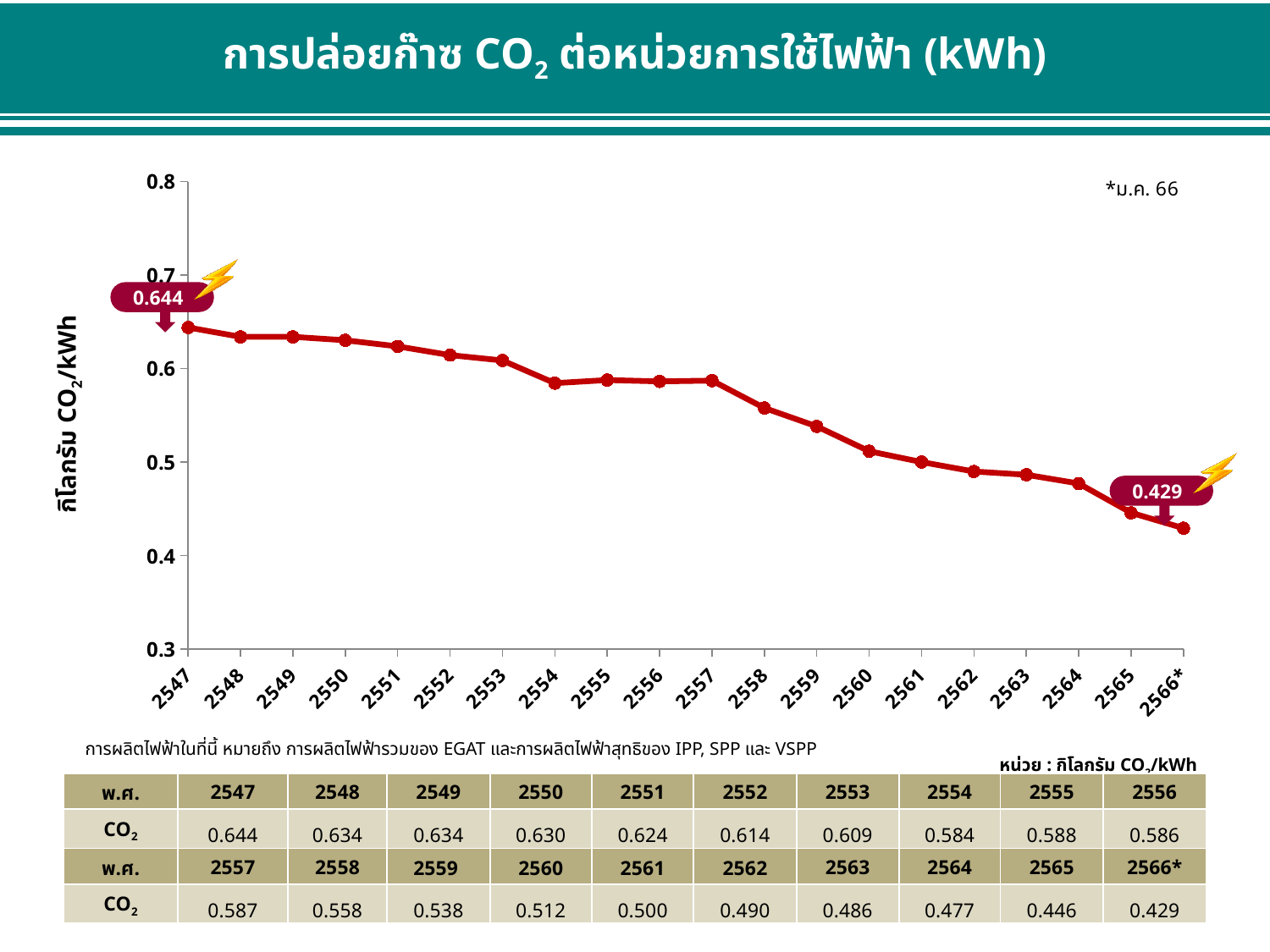
What is the difference between the CO2 values for 2557 and 2558? 0.029 What is the CO2 emission value for the year 2547? 0.644 What kind of chart is shown on the slide? line chart What is the CO2 emission value for the year 2560? 0.512 What is the CO2 emission value for the year 2554? 0.584 Which year has the larger CO2 value, 2558 or 2560? 2558 Which year has the lowest CO2 emission per kWh? 2566* How many years are plotted on the x axis? 20 Which year has the highest CO2 emission per kWh? 2547 What is the difference between the CO2 values for 2547 and 2566*? 0.215 Is the value for 2559 greater or less than 0.5? greater What is the CO2 emission value for the year 2566*? 0.429